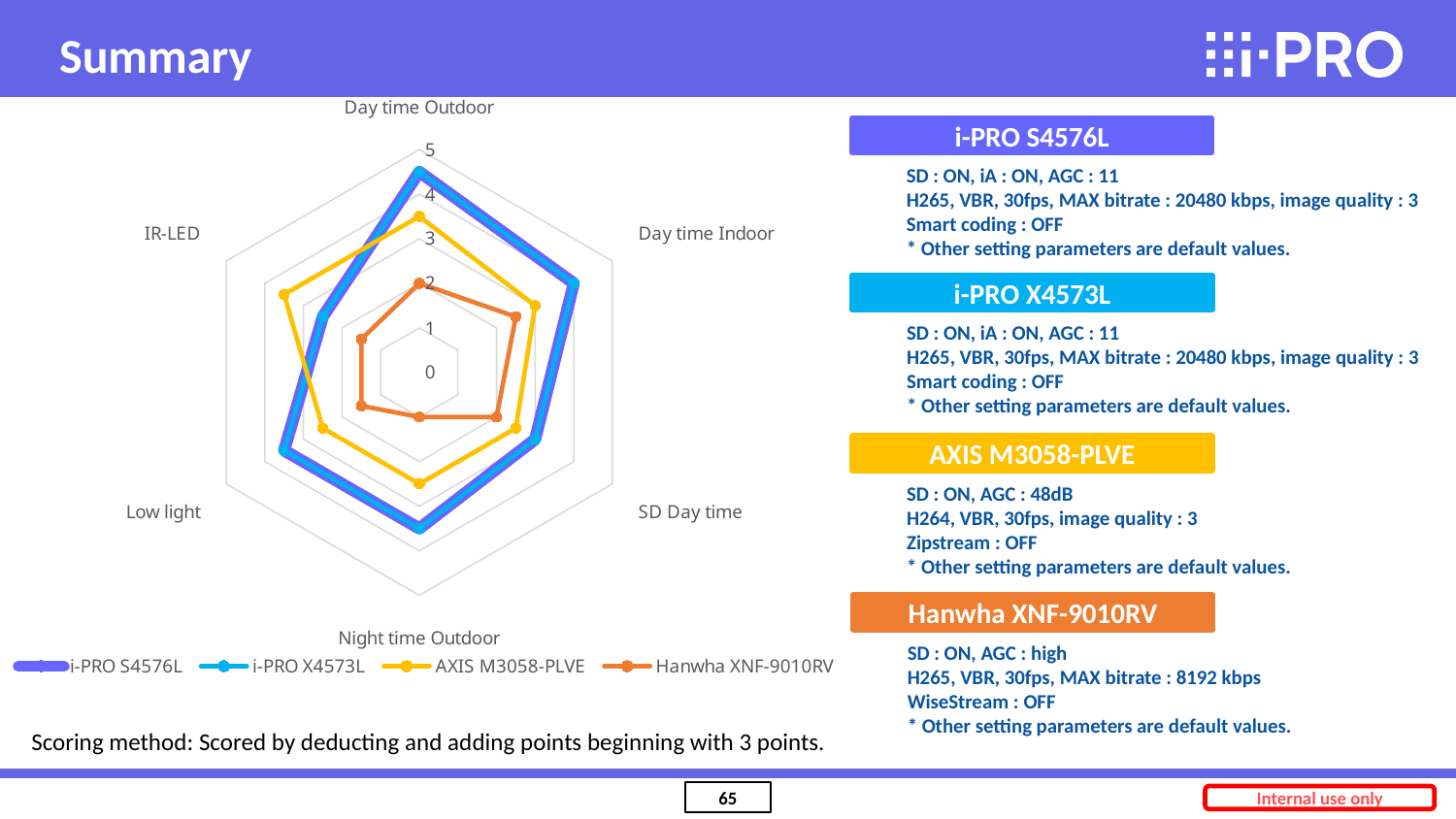
How many categories (axes) does the radar chart have? 6 What is the maximum value shown on the chart's scale? 5 On Low light, which has the larger value: i-PRO X4573L or Hanwha XNF-9010RV? i-PRO X4573L Which category label appears at the top of the radar chart? Day time Outdoor Is the value for Hanwha XNF-9010RV on Low light greater or less than 3? less Is the value for i-PRO S4576L on Day time Outdoor greater or less than 3? greater How many series does the chart legend list? 4 On Day time Indoor, which has the larger value: AXIS M3058-PLVE or Hanwha XNF-9010RV? AXIS M3058-PLVE What kind of chart is shown on the slide? Radar chart Is the value for Hanwha XNF-9010RV on Day time Outdoor greater or less than 3? less Which series has the lowest value on Night time Outdoor? Hanwha XNF-9010RV